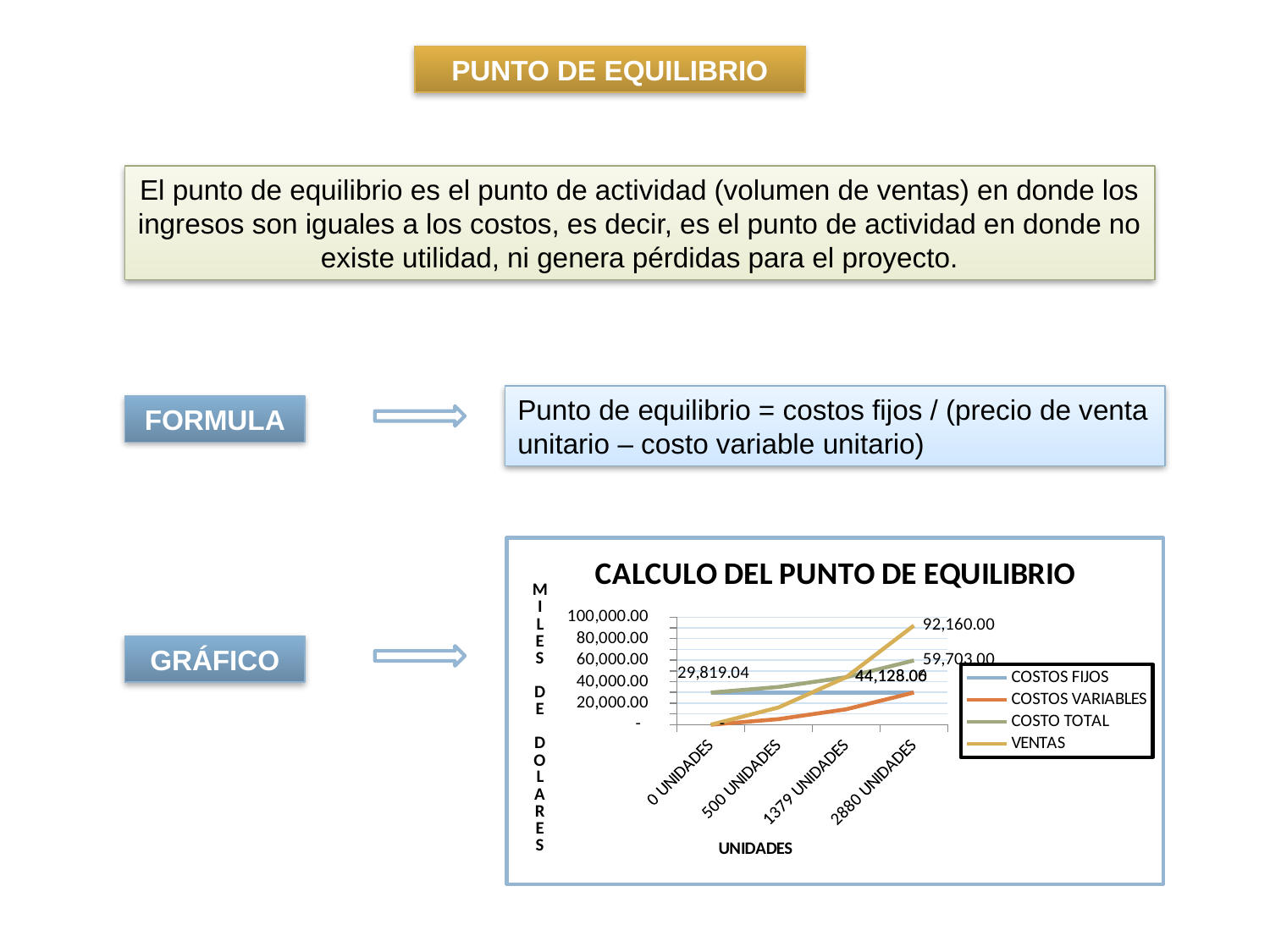
What is the difference between VENTAS and COSTO TOTAL at 2880 UNIDADES? 32,457.00 Is the value for COSTOS VARIABLES at 0 UNIDADES greater or less than 20,000.00? less Does the VENTAS line rise or fall from 0 UNIDADES to 2880 UNIDADES? Rise What is the value of COSTO TOTAL at 2880 UNIDADES? 59,703.00 Which series has the highest value at 2880 UNIDADES? VENTAS How many categories are shown on the x axis of the chart? 4 What type of chart is shown under 'CALCULO DEL PUNTO DE EQUILIBRIO'? Line chart What value is labelled at 0 UNIDADES on the chart? 29,819.04 At 2880 UNIDADES, which is larger: VENTAS or COSTO TOTAL? VENTAS What is the title of the chart on the slide? CALCULO DEL PUNTO DE EQUILIBRIO How many series does the chart legend list? 4 What is the value of VENTAS at 2880 UNIDADES? 92,160.00